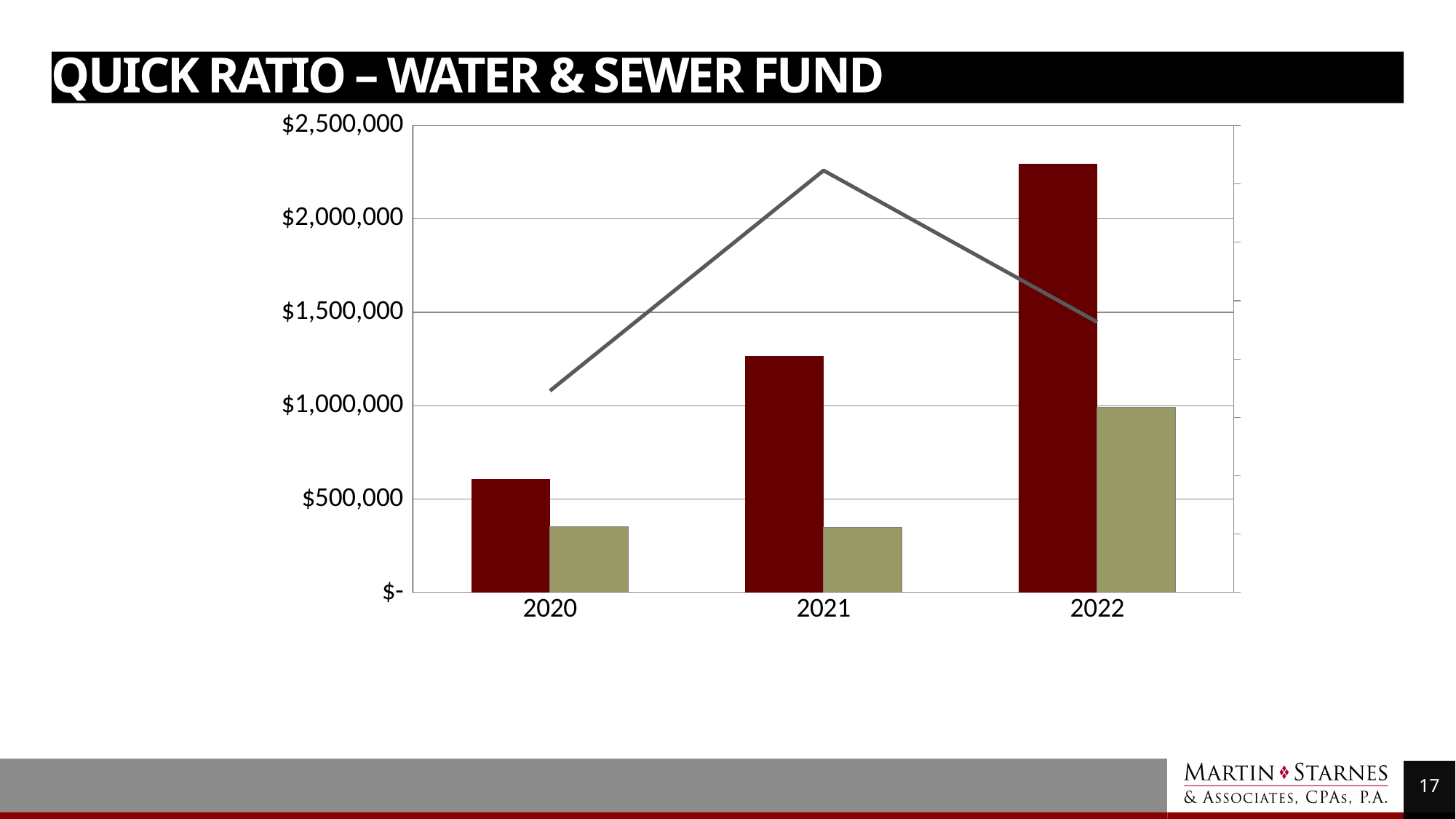
What is the title of the chart? Quick Ratio – Water & Sewer Fund How many years are shown on the x axis of the chart? 3 Is the dark red bar for 2022 greater or less than $2,000,000? greater What kind of chart is shown on the slide? A combined bar and line chart Which year has the shortest dark red bar? 2020 Is the dark red bar for 2020 greater or less than $500,000? greater Which year has the tallest dark red bar? 2022 Is the olive bar for 2020 greater or less than $500,000? less Do the dark red bars rise or fall from 2020 to 2022? Rise In 2022, which bar is taller, the dark red bar or the olive bar? The dark red bar In which year does the grey line reach its highest point? 2021